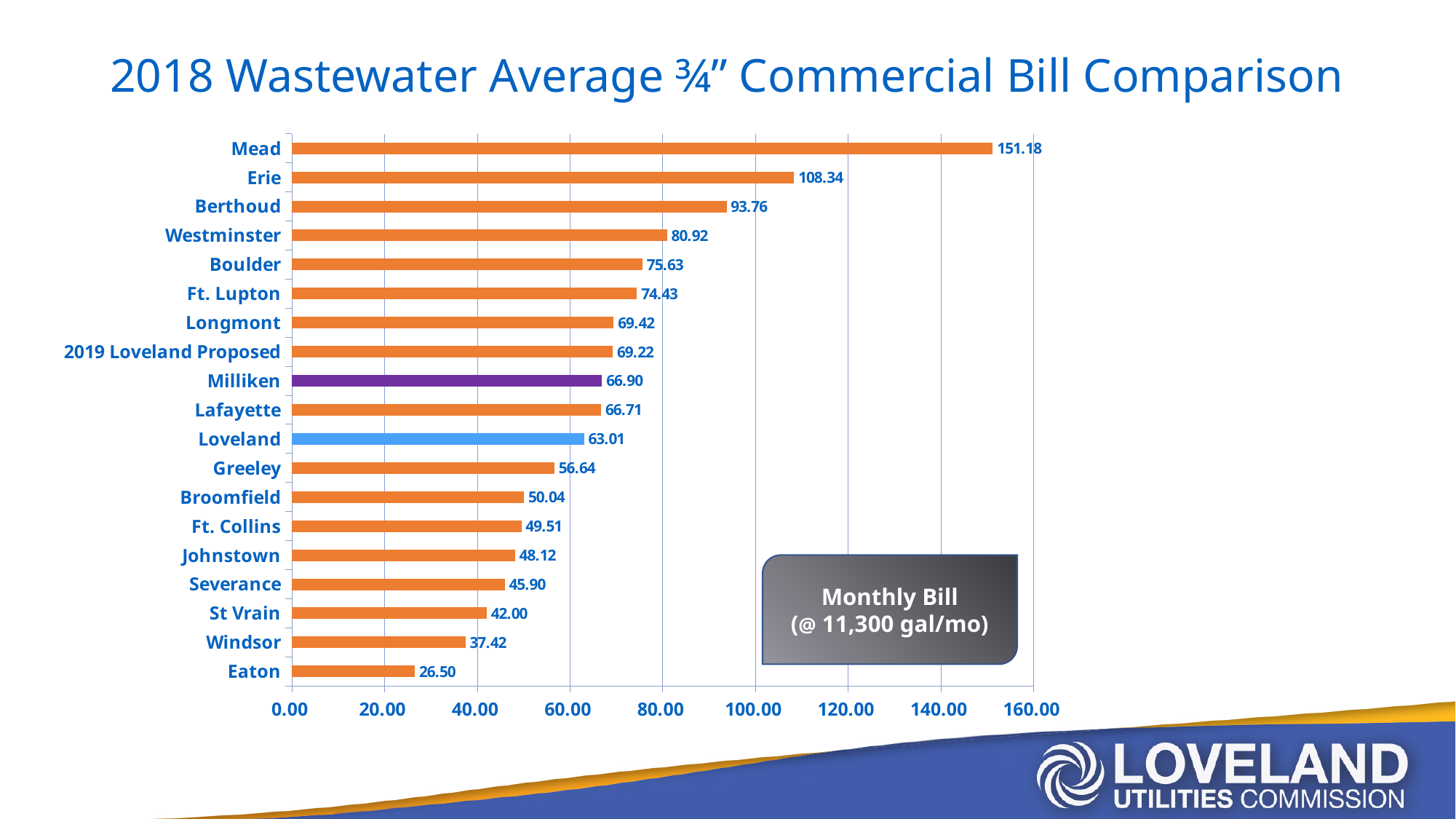
Which has a larger value, Erie or Berthoud? Erie Which category has the lowest value? Eaton What is the title of the chart? 2018 Wastewater Average ¾" Commercial Bill Comparison How many categories are shown in the chart? 19 What is the difference between the values for Mead and Eaton? 124.68 What is the value shown for 2019 Loveland Proposed? 69.22 What is the difference between the values for 2019 Loveland Proposed and Loveland? 6.21 What kind of chart is shown on the slide? Bar chart What is the value shown for Mead? 151.18 What is the value shown for Loveland? 63.01 What is the value shown for Windsor? 37.42 Which category has the highest value? Mead